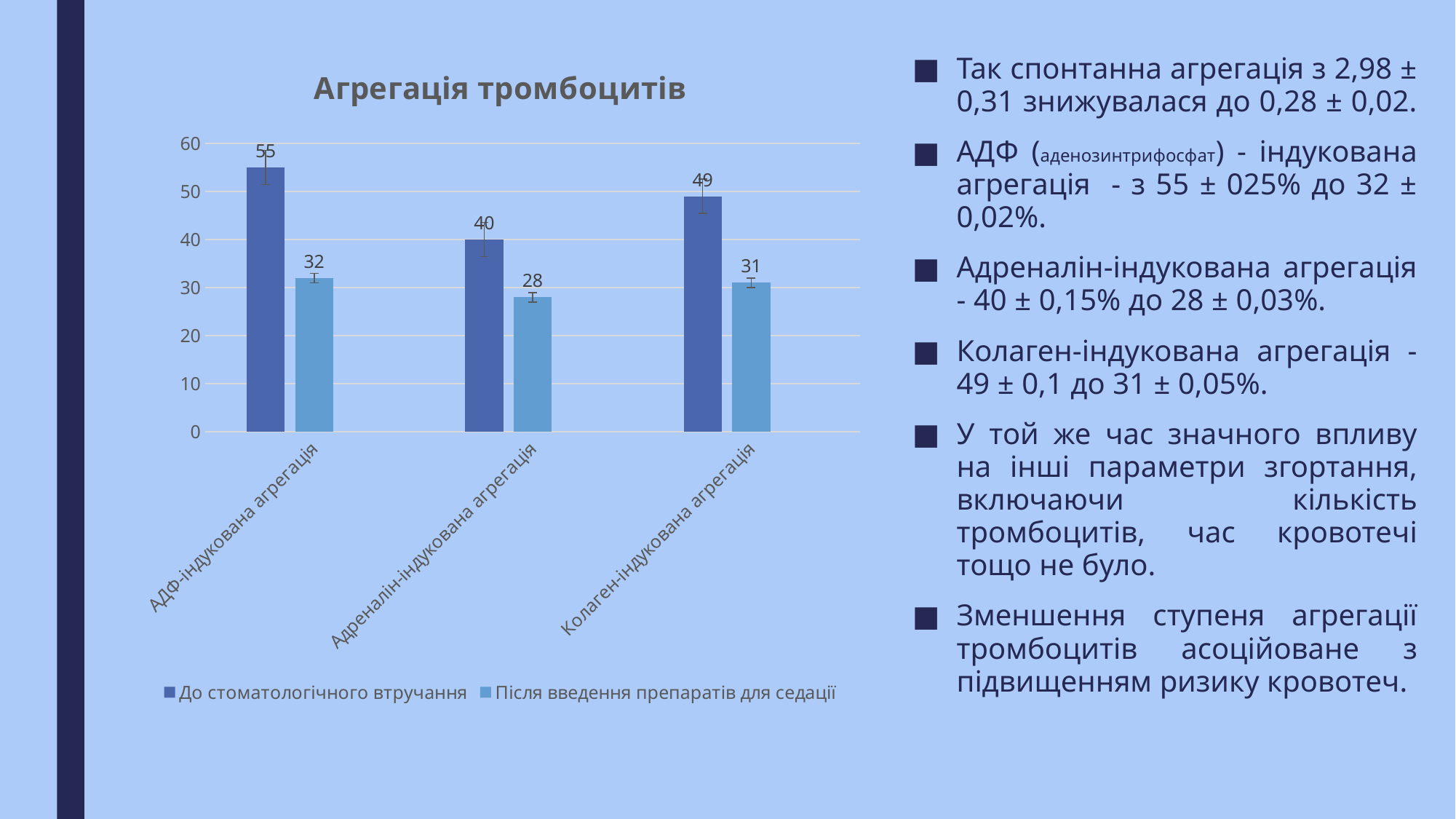
What is the value for Адреналін-індукована агрегація in the series Після введення препаратів для седації? 28 What is the value for Колаген-індукована агрегація in the series До стоматологічного втручання? 49 How many series does the legend list? 2 What is the title of the chart? Агрегація тромбоцитів Which category has the lowest value in the series Після введення препаратів для седації? Адреналін-індукована агрегація Which category has the highest value in the series До стоматологічного втручання? АДФ-індукована агрегація What kind of chart is shown on the slide? Bar chart What is the value for АДФ-індукована агрегація in the series До стоматологічного втручання? 55 What is the difference between the two series for АДФ-індукована агрегація? 23 Which is larger for Адреналін-індукована агрегація: До стоматологічного втручання or Після введення препаратів для седації? До стоматологічного втручання What is the difference between the two series for Колаген-індукована агрегація? 18 How many categories are shown on the x axis? 3